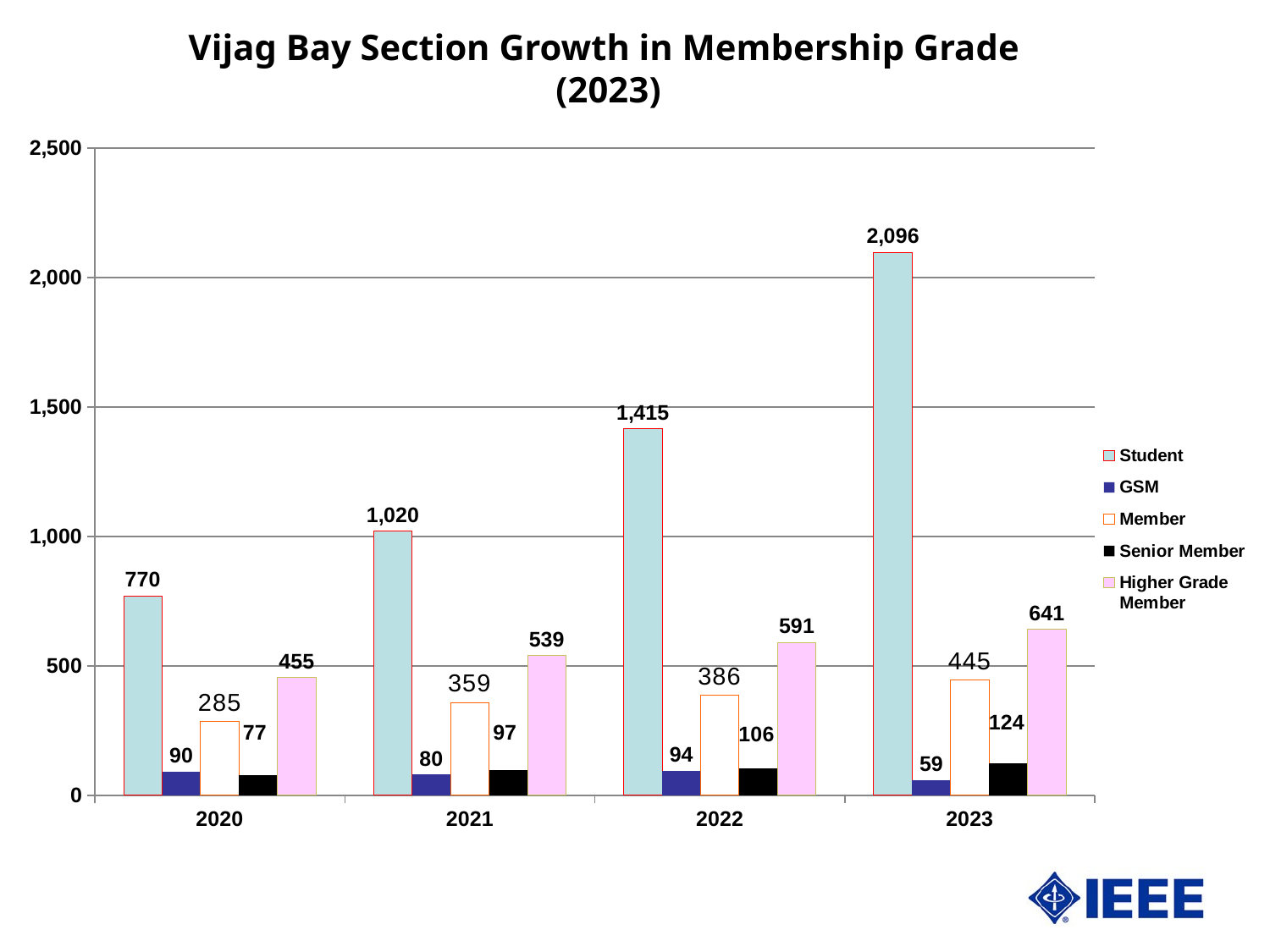
How many years are shown on the x axis? 4 Which year has the lowest GSM value? 2023 Which is larger in 2021: Higher Grade Member or Member? Higher Grade Member What kind of chart is shown on the slide? Bar chart What is the value for GSM in 2020? 90 Which year has the highest Student value? 2023 How many series does the legend list? 5 Is the Student value for 2021 greater or less than 1,000? greater What is the value for Senior Member in 2022? 106 What is the value for Member in 2021? 359 What is the difference between the Student values for 2023 and 2022? 681 What is the value for Student in 2023? 2,096